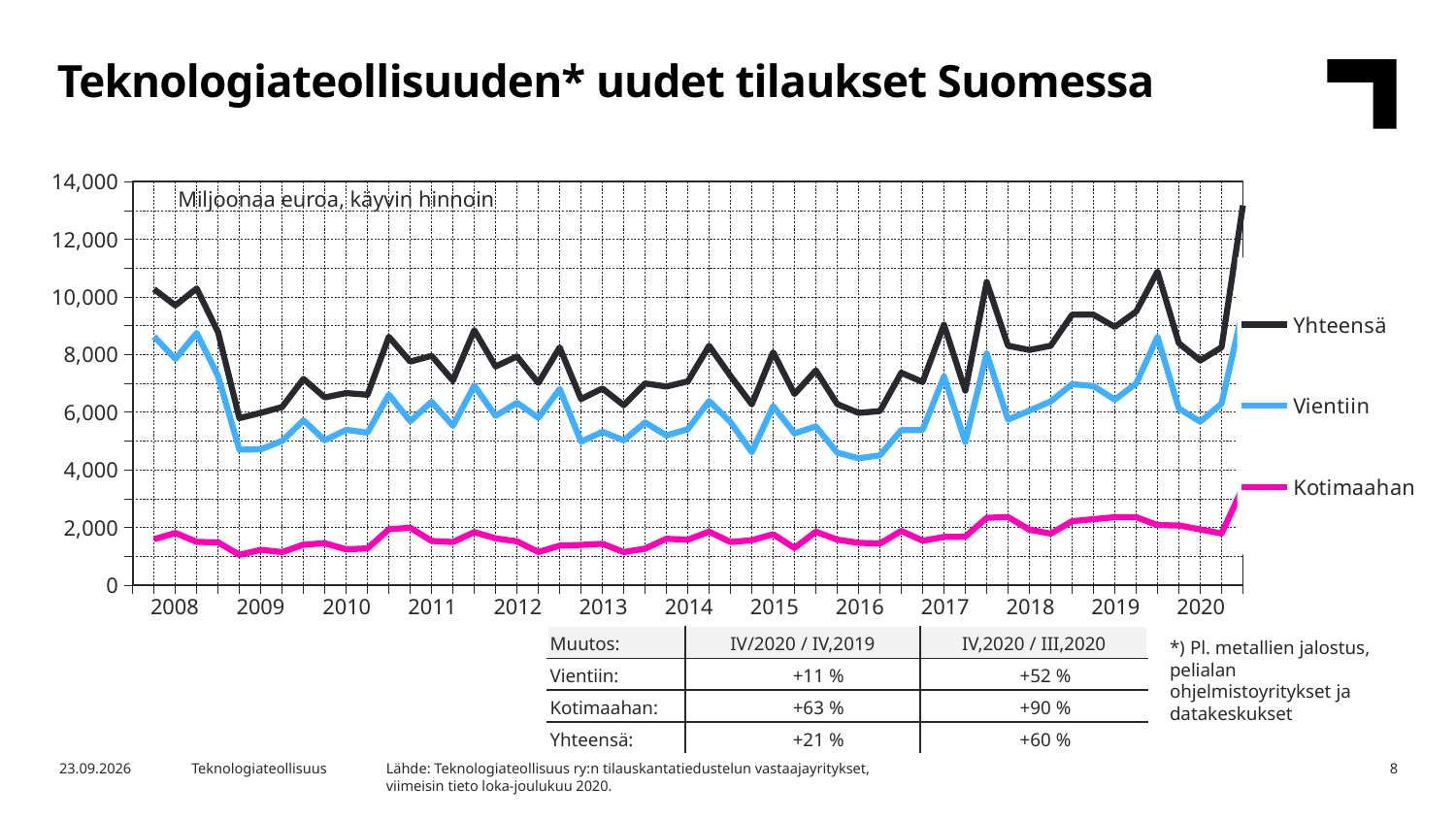
Is the value for Yhteensä at the last point in 2020 greater or less than 12,000? greater Which series has the highest values throughout the chart? Yhteensä Does the Yhteensä line rise or fall from the start of 2008 to the start of 2009? fall How many series does the legend list? 3 Is the value for Vientiin at the last point in 2020 greater or less than 8,000? greater What kind of chart is shown on the slide? line chart Is the value for Kotimaahan at the start of 2008 greater or less than 4,000? less Which series has the lowest values throughout the chart? Kotimaahan Which is larger at the start of 2008, Vientiin or Kotimaahan? Vientiin What unit label is shown inside the chart area? Miljoonaa euroa, käyvin hinnoin How many years are labelled on the x axis? 13